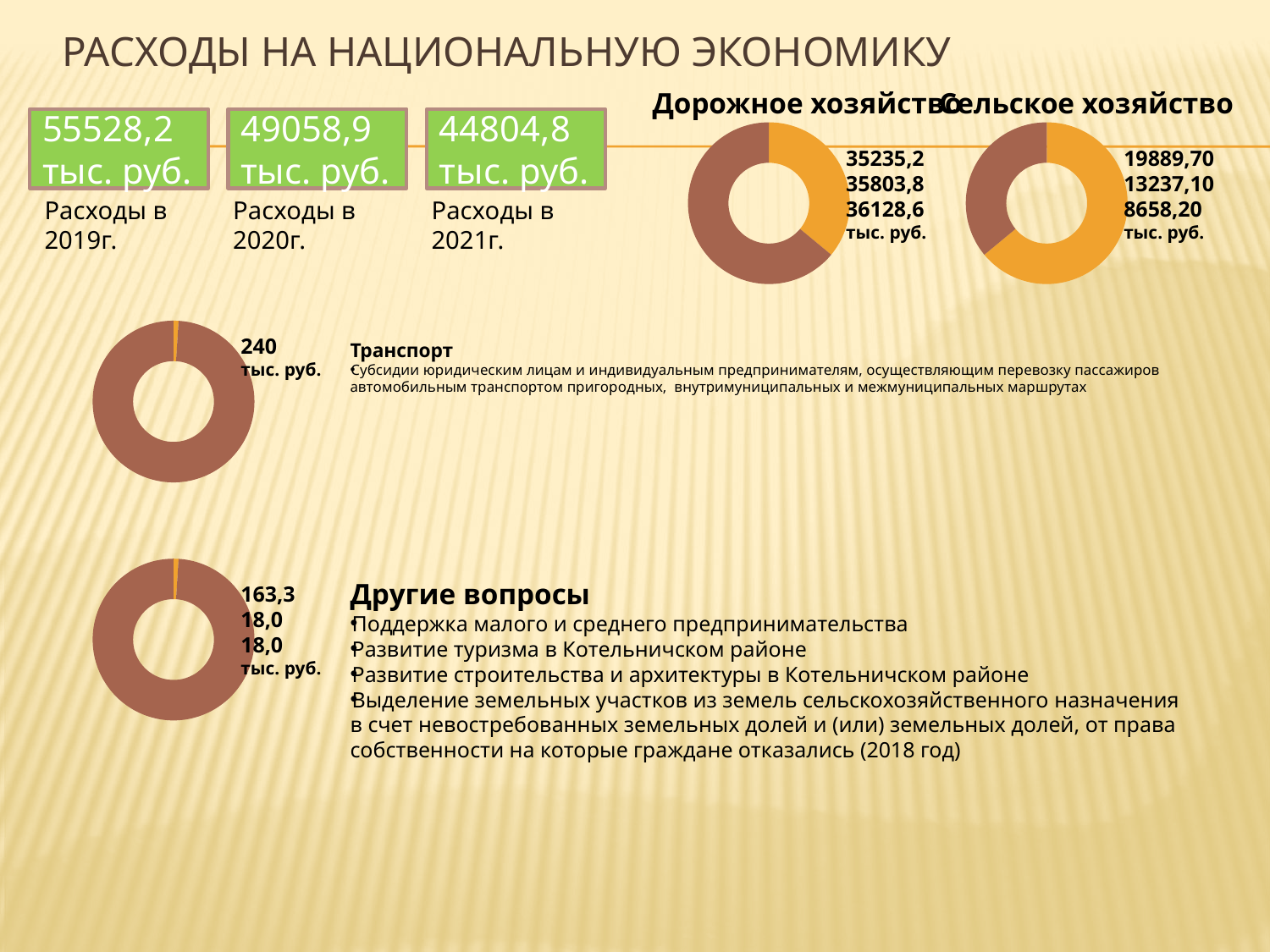
In the doughnut chart next to "Транспорт", which colour fills almost the entire ring? brown What value is printed next to the doughnut chart for "Транспорт"? 240 тыс. руб. What is the largest value printed next to the "Другие вопросы" doughnut chart? 163,3 How many doughnut charts are on the slide? 4 What is the title of the chart to the right of the "Дорожное хозяйство" chart? Сельское хозяйство What is the difference between the values 35803,8 and 35235,2 printed next to the "Дорожное хозяйство" chart? 568,6 What is the smallest of the three values printed next to the "Сельское хозяйство" chart? 8658,20 In the "Дорожное хозяйство" doughnut chart, which slice is larger, the brown one or the orange one? brown What is the first value printed next to the "Сельское хозяйство" chart? 19889,70 What kind of chart is shown under the title "Дорожное хозяйство"? doughnut chart What is the difference between the first two values printed next to the "Сельское хозяйство" chart, 19889,70 and 13237,10? 6652,60 What is the largest of the three values printed next to the "Дорожное хозяйство" chart? 36128,6